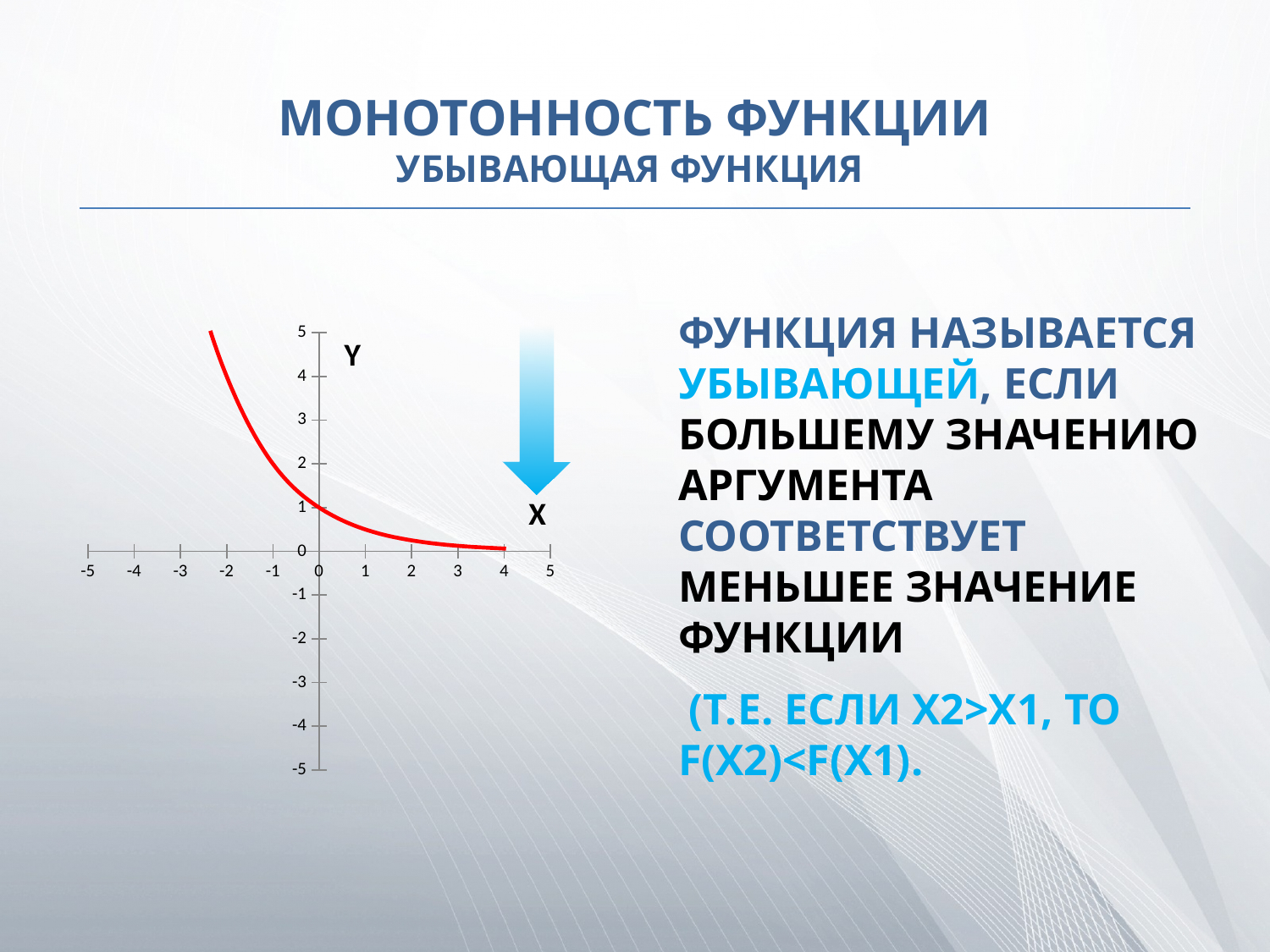
What kind of chart is shown on the slide? line chart Is the value of the function at x = -2 greater or less than 3? greater Does the plotted curve rise or fall as x increases? fall Which is larger: the value of the function at x = -2 or at x = 2? at x = -2 Which is larger: the value of the function at x = -1 or at x = 1? at x = -1 Is the value of the function at x = -1 greater or less than 1? greater Is the value of the function at x = 3 greater or less than 1? less What is the lowest value shown on the vertical axis? -5 What is the highest value shown on the horizontal axis? 5